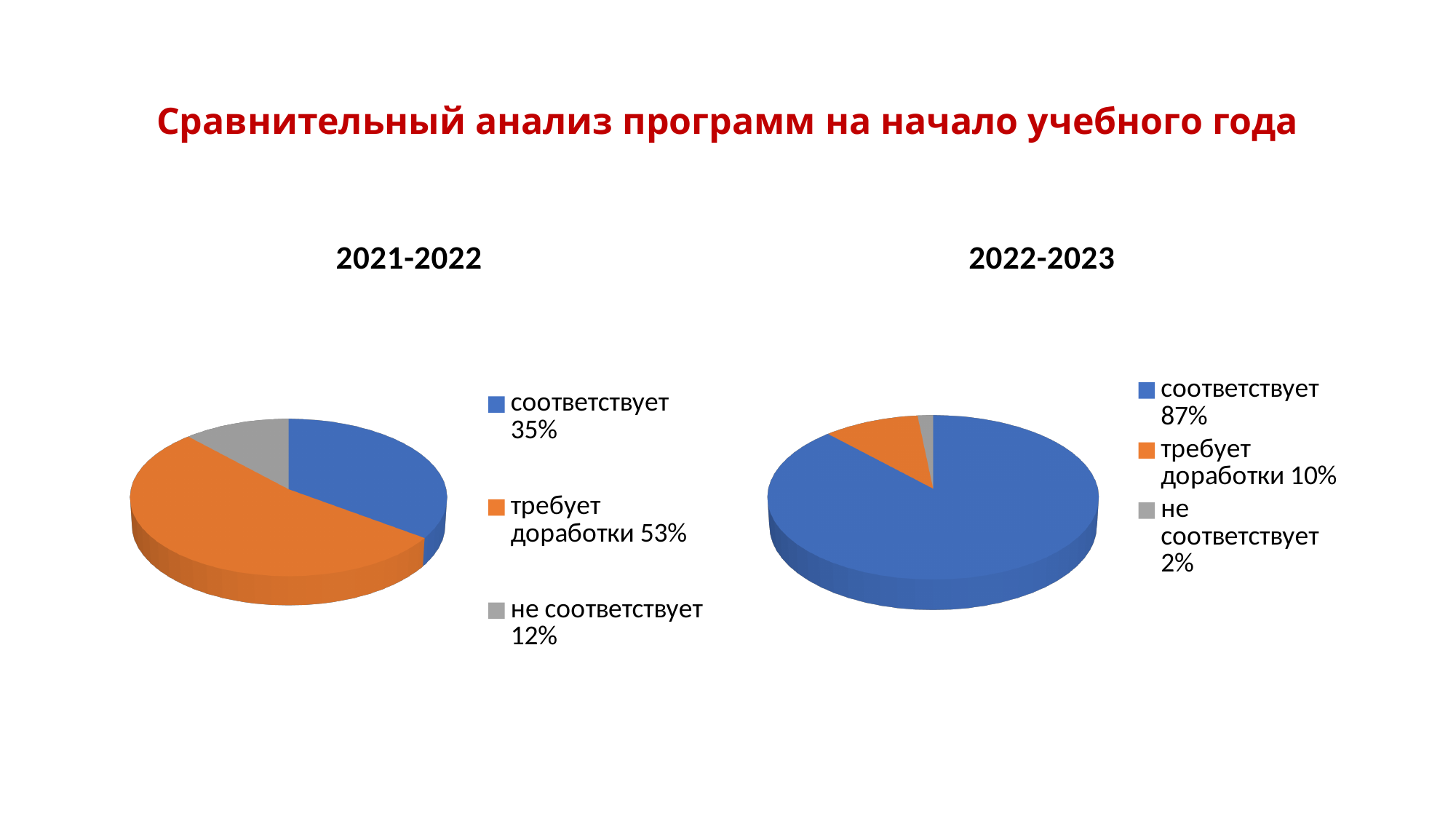
In the 2022-2023 chart, what share is labelled for "не соответствует"? 2% In the 2021-2022 chart, which category has the largest slice? требует доработки In the 2021-2022 chart, what share is labelled for "не соответствует"? 12% In the 2021-2022 chart, what share is labelled for "требует доработки"? 53% In the 2022-2023 chart, what share is labelled for "требует доработки"? 10% Which is larger: "требует доработки" in the 2021-2022 chart or "требует доработки" in the 2022-2023 chart? 2021-2022 In the 2022-2023 chart, which category has the smallest slice? не соответствует What is the difference between the "соответствует" share in the 2022-2023 chart and in the 2021-2022 chart? 52% In the 2021-2022 chart, what share is labelled for "соответствует"? 35% What kind of chart is the 2022-2023 chart? pie chart How many categories does the legend of the 2021-2022 chart list? 3 In the 2022-2023 chart, what share is labelled for "соответствует"? 87%